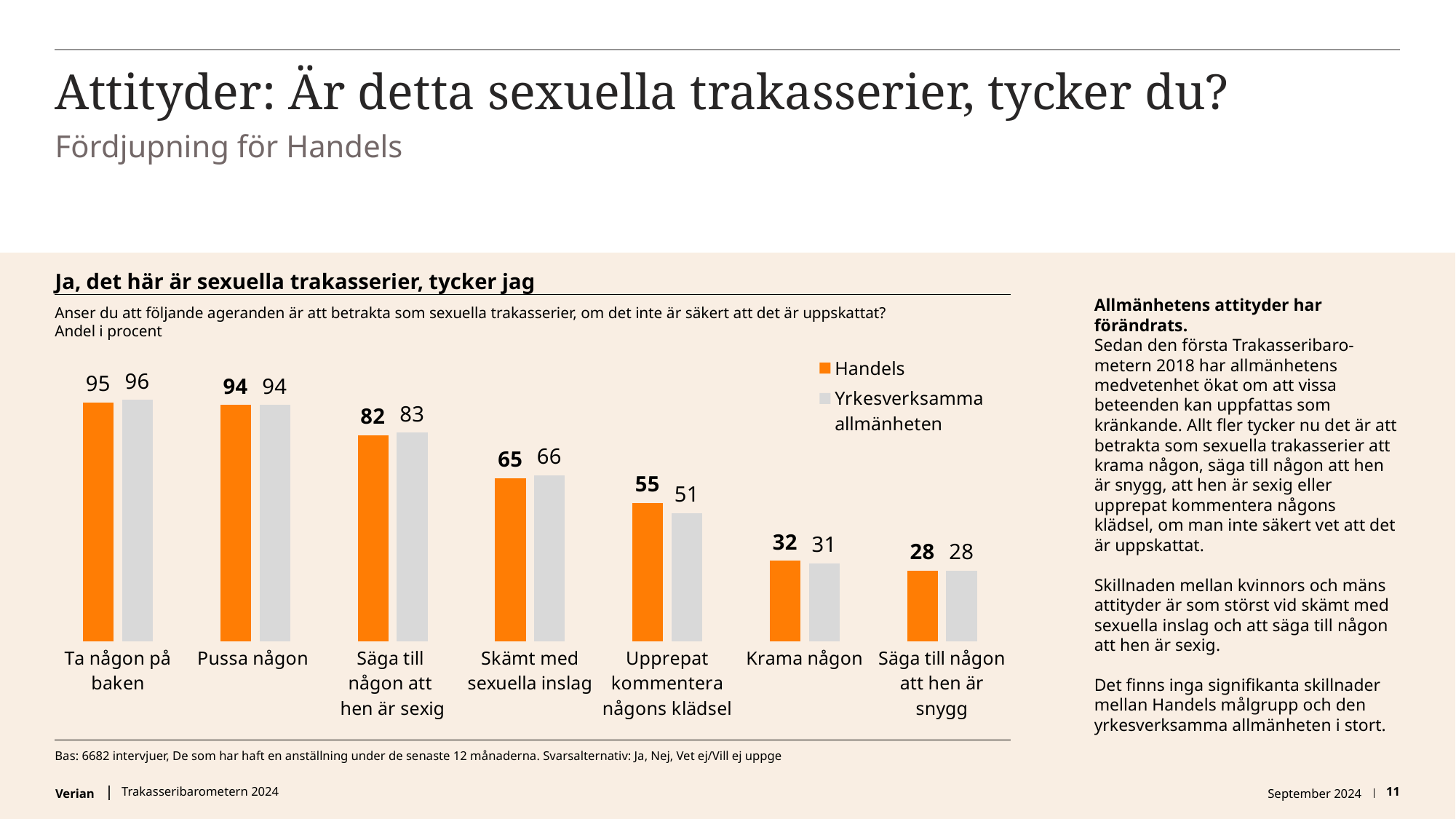
Which category has the highest Handels value? Ta någon på baken What is the Handels value for "Skämt med sexuella inslag"? 65 What colour are the Handels bars? Orange What is the Handels value for "Ta någon på baken"? 95 How many categories are shown on the x axis? 7 For "Krama någon", which series has the larger value, Handels or Yrkesverksamma allmänheten? Handels What is the Yrkesverksamma allmänheten value for "Upprepat kommentera någons klädsel"? 51 Do the Handels values rise or fall from left to right along the x axis? Fall Which category has the lowest Yrkesverksamma allmänheten value? Säga till någon att hen är snygg What is the difference between the Handels and Yrkesverksamma allmänheten values for "Upprepat kommentera någons klädsel"? 4 How many series does the legend list? 2 What kind of chart is shown on the slide? Bar chart